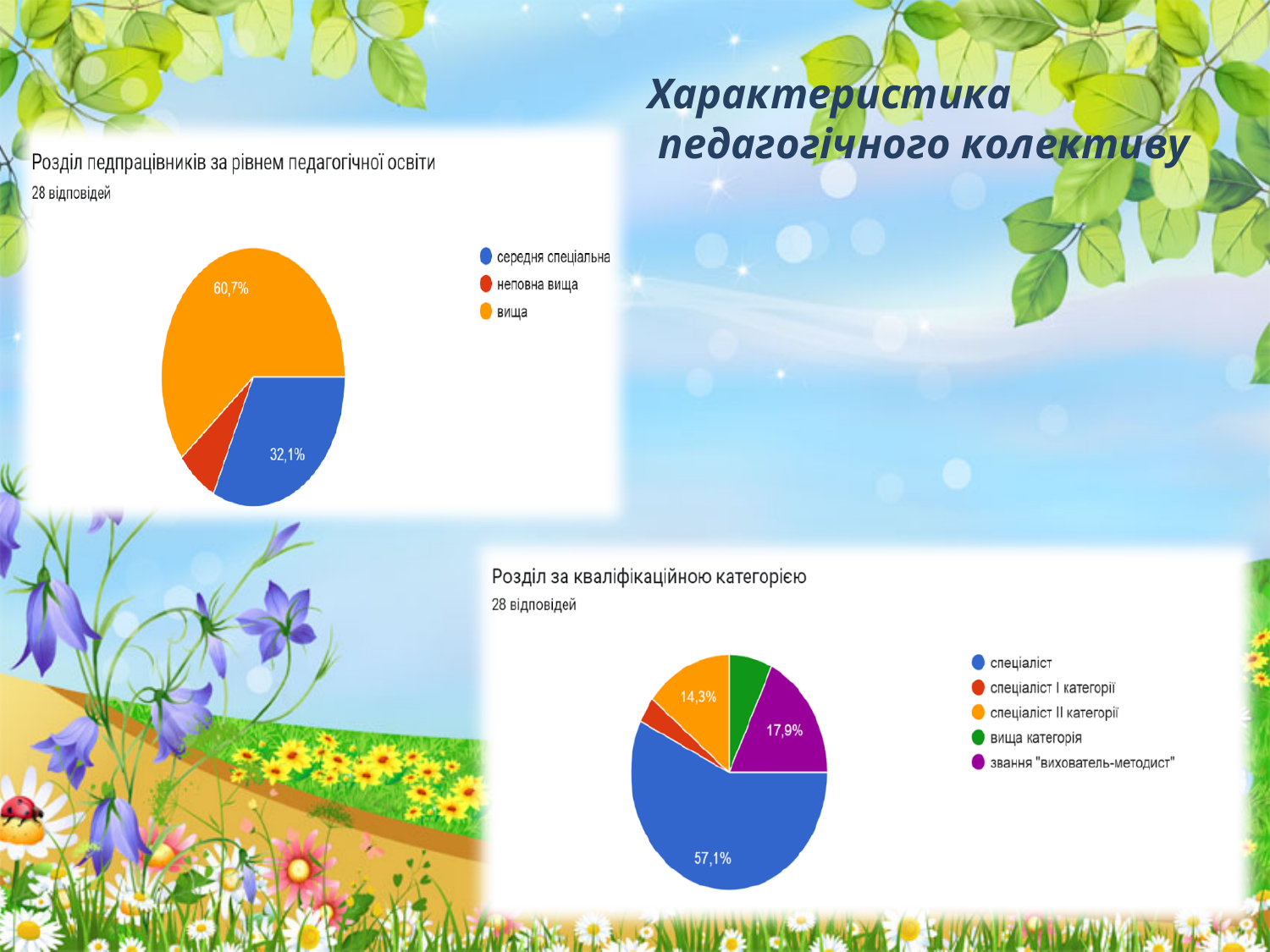
In the chart titled "Розділ за кваліфікаційною категорією", what share of the pie is labelled for "спеціаліст"? 57,1% In the chart titled "Розділ за кваліфікаційною категорією", what share of the pie is labelled for "звання "вихователь-методист""? 17,9% In the chart titled "Розділ педпрацівників за рівнем педагогічної освіти", what is the difference in percentage points between the "вища" and "середня спеціальна" slices? 28,6% In the chart titled "Розділ за кваліфікаційною категорією", what share of the pie is labelled for "спеціаліст II категорії"? 14,3% In the chart titled "Розділ педпрацівників за рівнем педагогічної освіти", which category has the smallest slice? неповна вища In the chart titled "Розділ педпрацівників за рівнем педагогічної освіти", what share of the pie is labelled for "середня спеціальна"? 32,1% What type of chart is used in the chart titled "Розділ за кваліфікаційною категорією"? pie chart In the chart titled "Розділ за кваліфікаційною категорією", which category has the largest slice? спеціаліст How many categories does the legend list in the chart titled "Розділ педпрацівників за рівнем педагогічної освіти"? 3 In the chart titled "Розділ педпрацівників за рівнем педагогічної освіти", which category has the largest slice? вища In the chart titled "Розділ педпрацівників за рівнем педагогічної освіти", what share of the pie is labelled for "вища"? 60,7% How many categories does the legend list in the chart titled "Розділ за кваліфікаційною категорією"? 5